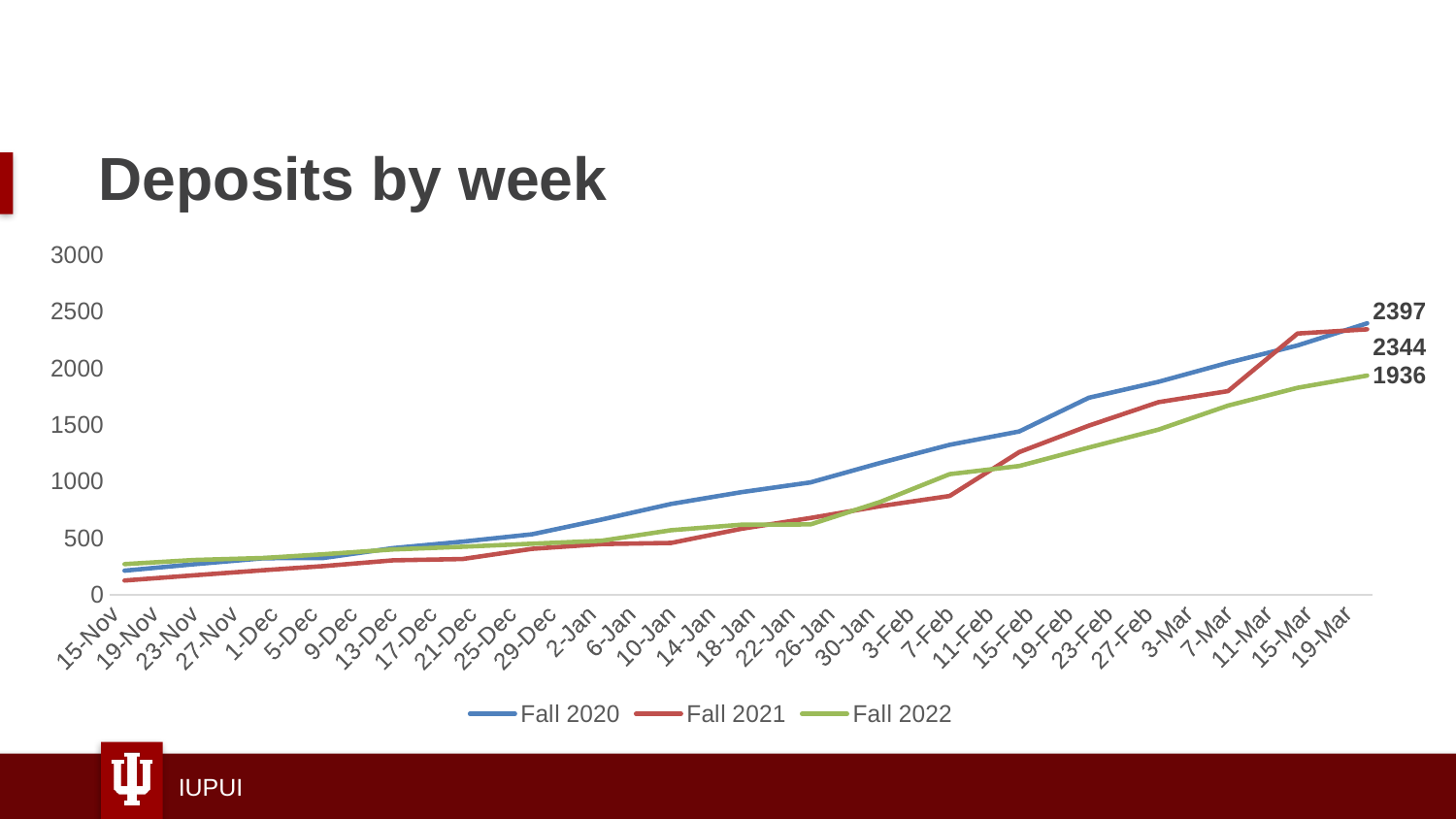
At 19-Mar, which is larger: Fall 2021 or Fall 2022? Fall 2021 What is the final value shown for Fall 2020 at 19-Mar? 2397 What is the final value shown for Fall 2022 at 19-Mar? 1936 Is the value for Fall 2020 at 7-Feb greater or less than 1000? greater What kind of chart is shown on the slide? line chart What is the difference between the Fall 2021 and Fall 2022 values at 19-Mar? 408 What is the difference between the Fall 2020 and Fall 2022 values at 19-Mar? 461 Which series has the highest value at 19-Mar? Fall 2020 Which series has the lowest value at 19-Mar? Fall 2022 How many series does the legend list? 3 Do the values for Fall 2020 rise or fall from 15-Nov to 19-Mar? rise What is the final value shown for Fall 2021 at 19-Mar? 2344